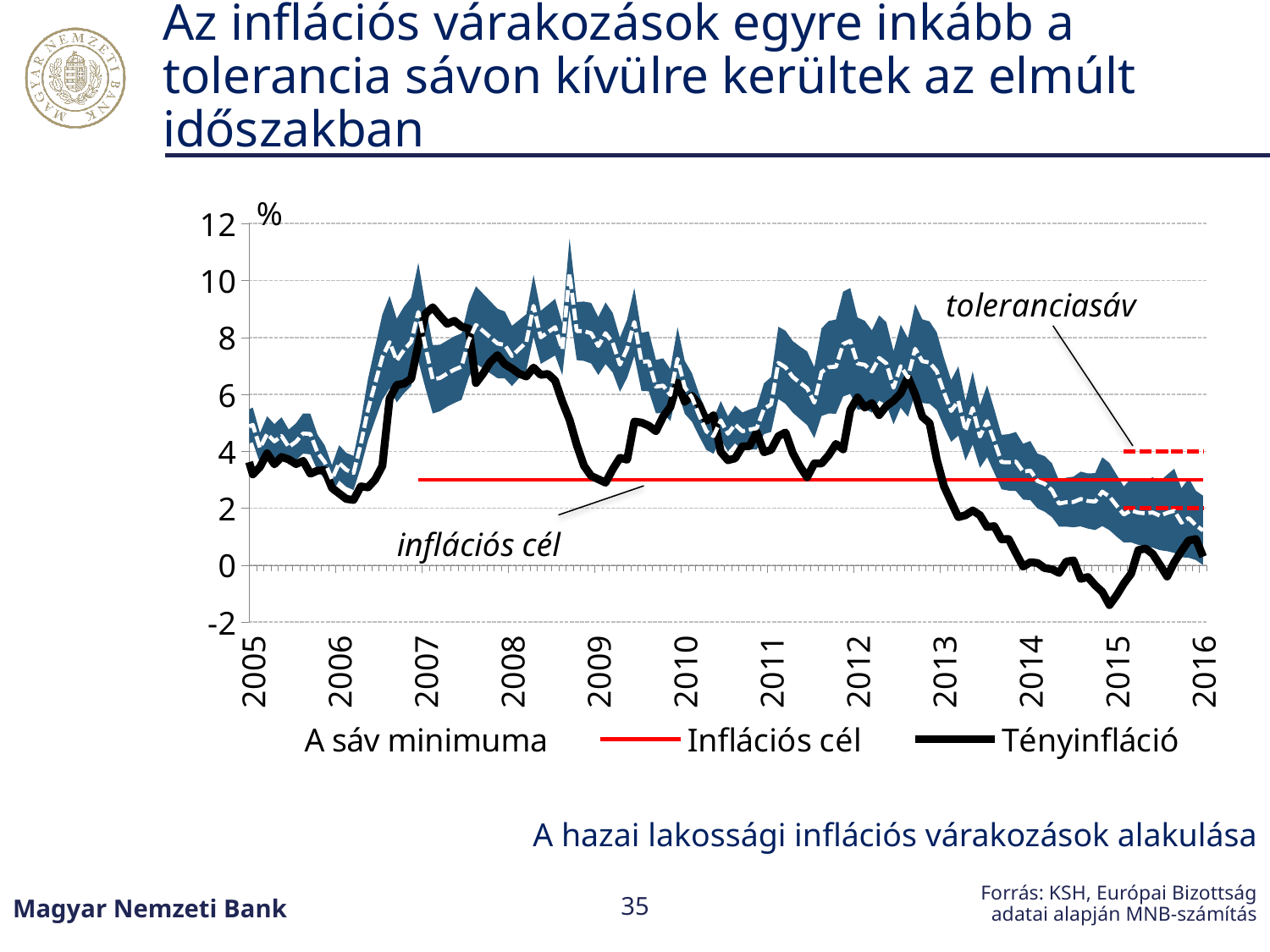
Does 'Tényinfláció' rise or fall between 2013 and 2015? fall What is the upper dashed line of the 'toleranciasáv' at on the y axis? 4 Is the value of 'Tényinfláció' at the start of 2015 greater or less than 2? less What unit is shown at the top of the y axis? % What kind of chart is shown on the slide? combination area and line chart How many series does the legend list? 3 Does the shaded expectations band rise or fall between 2012 and 2016? fall Is the value of 'Tényinfláció' at the start of 2007 greater or less than 6? greater What value does the red 'Inflációs cél' line sit at on the y axis? 3 What is the caption given below the chart? A hazai lakossági inflációs várakozások alakulása What is the lower dashed line of the 'toleranciasáv' at on the y axis? 2